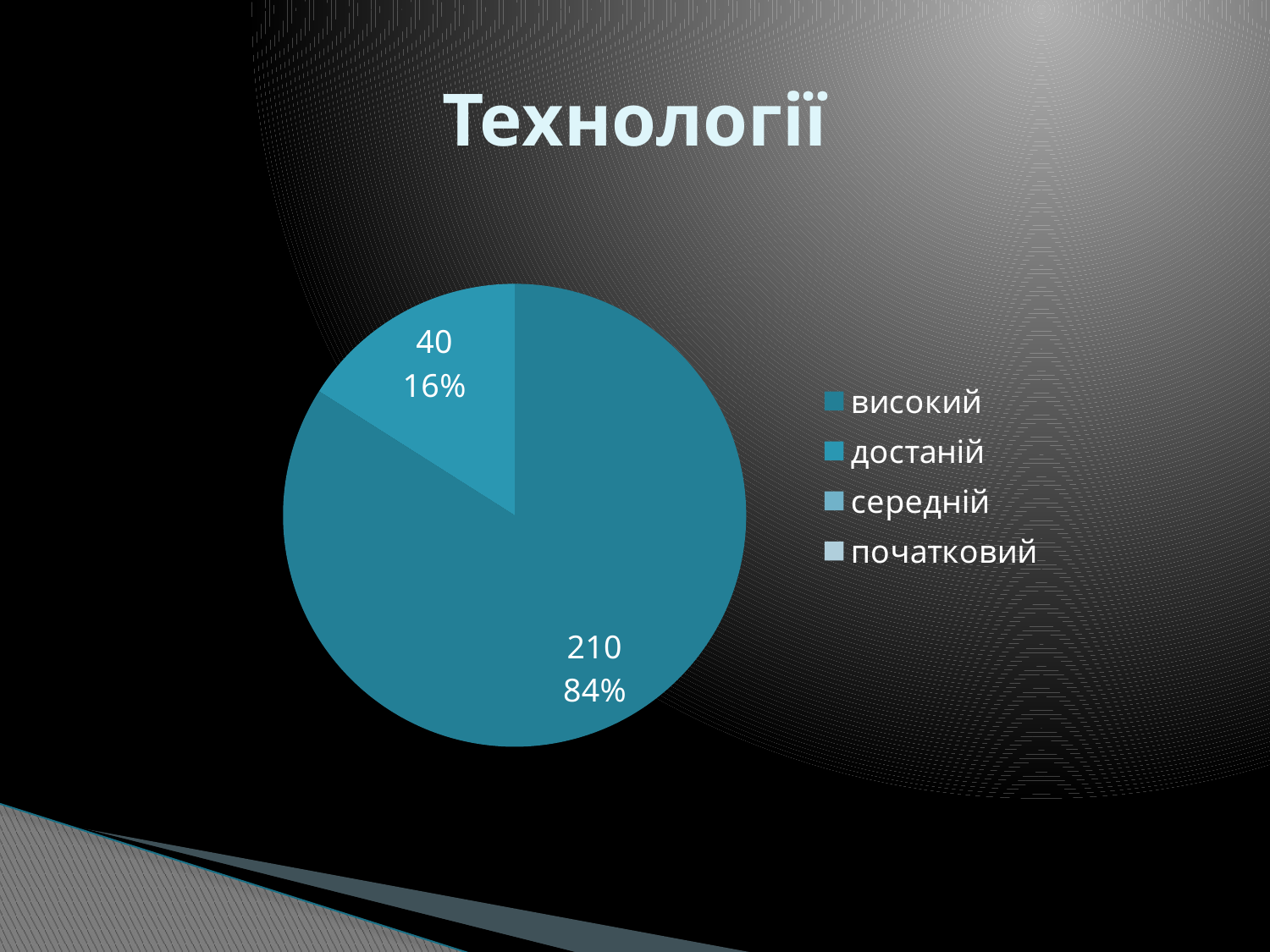
Which is larger, the slice for високий or the slice for достаній? високий Which legend category corresponds to the slice labelled 40? достаній What is the title of the chart? Технології Which legend category corresponds to the largest slice of the pie? високий What value is shown on the largest slice of the pie? 210 What percentage share does the slice labelled 210 have? 84% What is the difference between the two labelled slice values, 210 and 40? 170 What value is shown on the smaller labelled slice of the pie? 40 What is the total of the two labelled slice values? 250 What kind of chart is shown on the slide? pie chart How many entries does the chart legend list? 4 What percentage share does the slice labelled 40 have? 16%